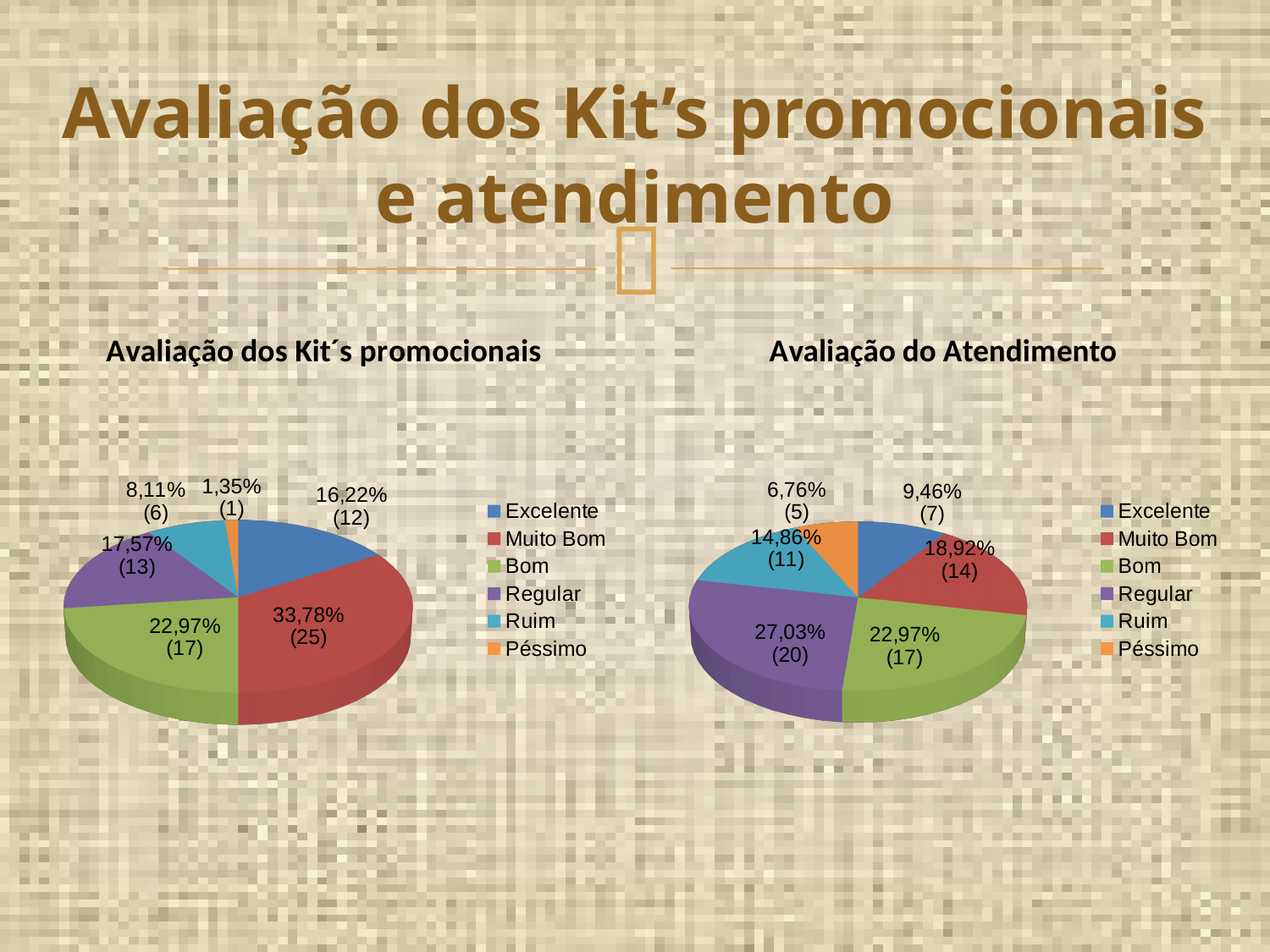
In the "Avaliação do Atendimento" chart, what share does Regular have? 27,03% In the "Avaliação do Atendimento" chart, how many responses are in the Excelente slice? 7 In the "Avaliação do Atendimento" chart, which category has the largest slice? Regular In the "Avaliação dos Kit´s promocionais" chart, how many responses are in the Regular slice? 13 In the "Avaliação dos Kit´s promocionais" chart, what share does Muito Bom have? 33,78% In the "Avaliação do Atendimento" chart, which is larger, Muito Bom or Ruim? Muito Bom In the "Avaliação dos Kit´s promocionais" chart, which category has the smallest slice? Péssimo In the "Avaliação dos Kit´s promocionais" chart, how many more responses does Bom have than Ruim? 11 In the "Avaliação do Atendimento" chart, what colour is the Péssimo slice? Orange In the "Avaliação dos Kit´s promocionais" chart, which category has the largest slice? Muito Bom What kind of chart is used for "Avaliação dos Kit´s promocionais"? Pie chart How many categories does the legend of the "Avaliação do Atendimento" chart list? 6